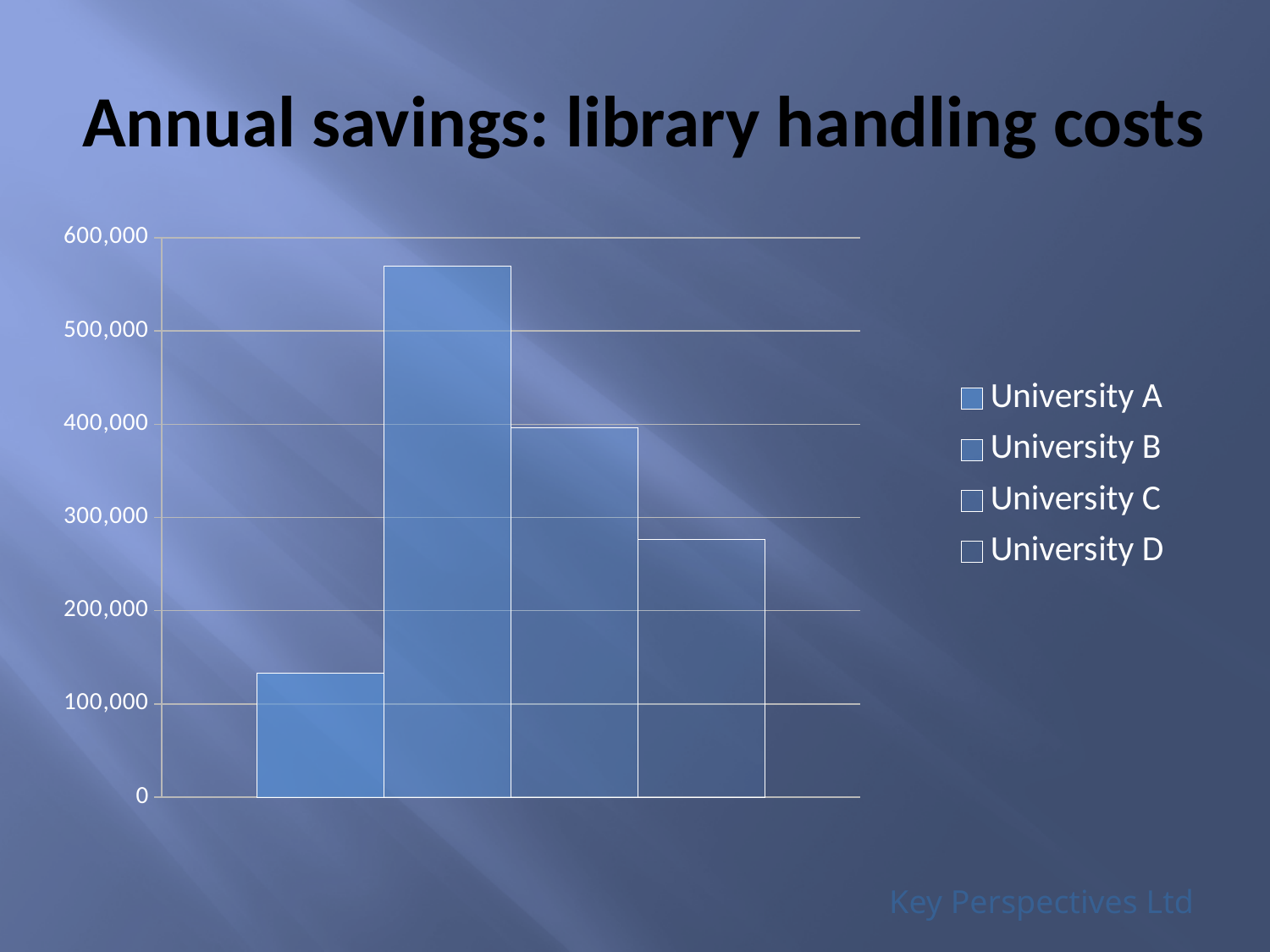
Is the value for University C greater or less than 300,000? greater Which university has the highest annual savings in library handling costs? University B Which has larger annual savings, University A or University D? University D How many bars are plotted in the chart? 4 Is the value for University B greater or less than 500,000? greater Which has larger annual savings, University C or University D? University C How many series does the legend list? 4 What is the title of the chart? Annual savings: library handling costs Is the value for University A greater or less than 200,000? less Which university has the lowest annual savings in library handling costs? University A What kind of chart is shown on the slide? Bar chart